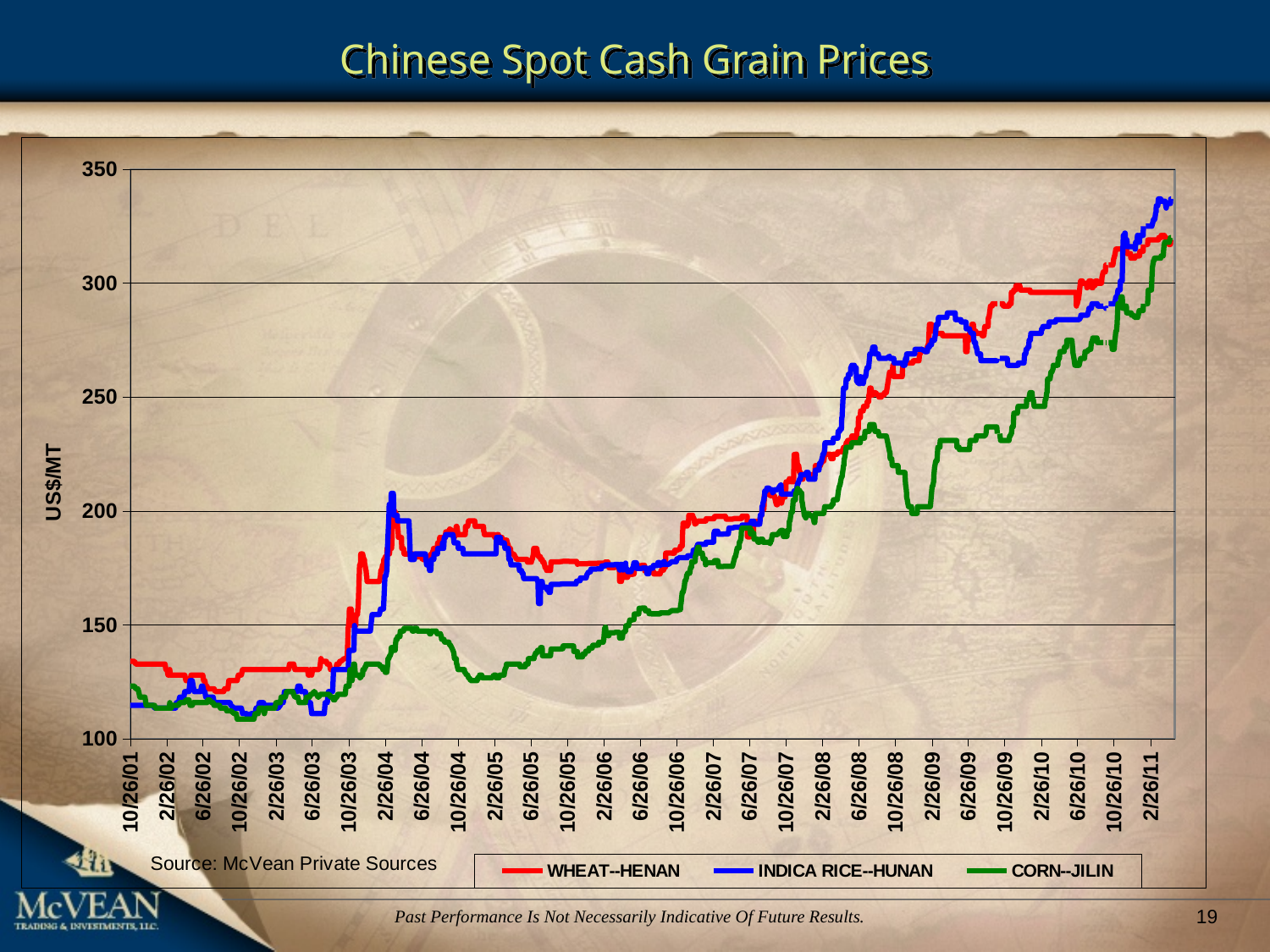
Is the value for WHEAT--HENAN at 2/26/08 greater or less than 200? greater What is the label on the vertical axis? US$/MT Is the value for CORN--JILIN at 10/26/04 greater or less than 150? less Which series has the highest value at the right end of the chart (2/26/11)? INDICA RICE--HUNAN What kind of chart is shown on the slide? Line chart What is the title of the chart? Chinese Spot Cash Grain Prices How many series does the legend list? 3 At 2/26/09, which is higher: INDICA RICE--HUNAN or CORN--JILIN? INDICA RICE--HUNAN Do the grain prices generally rise or fall from 10/26/01 to 2/26/11? Rise Is the value for CORN--JILIN at 2/26/06 greater or less than 150? less Which series has the lowest value at 2/26/09? CORN--JILIN